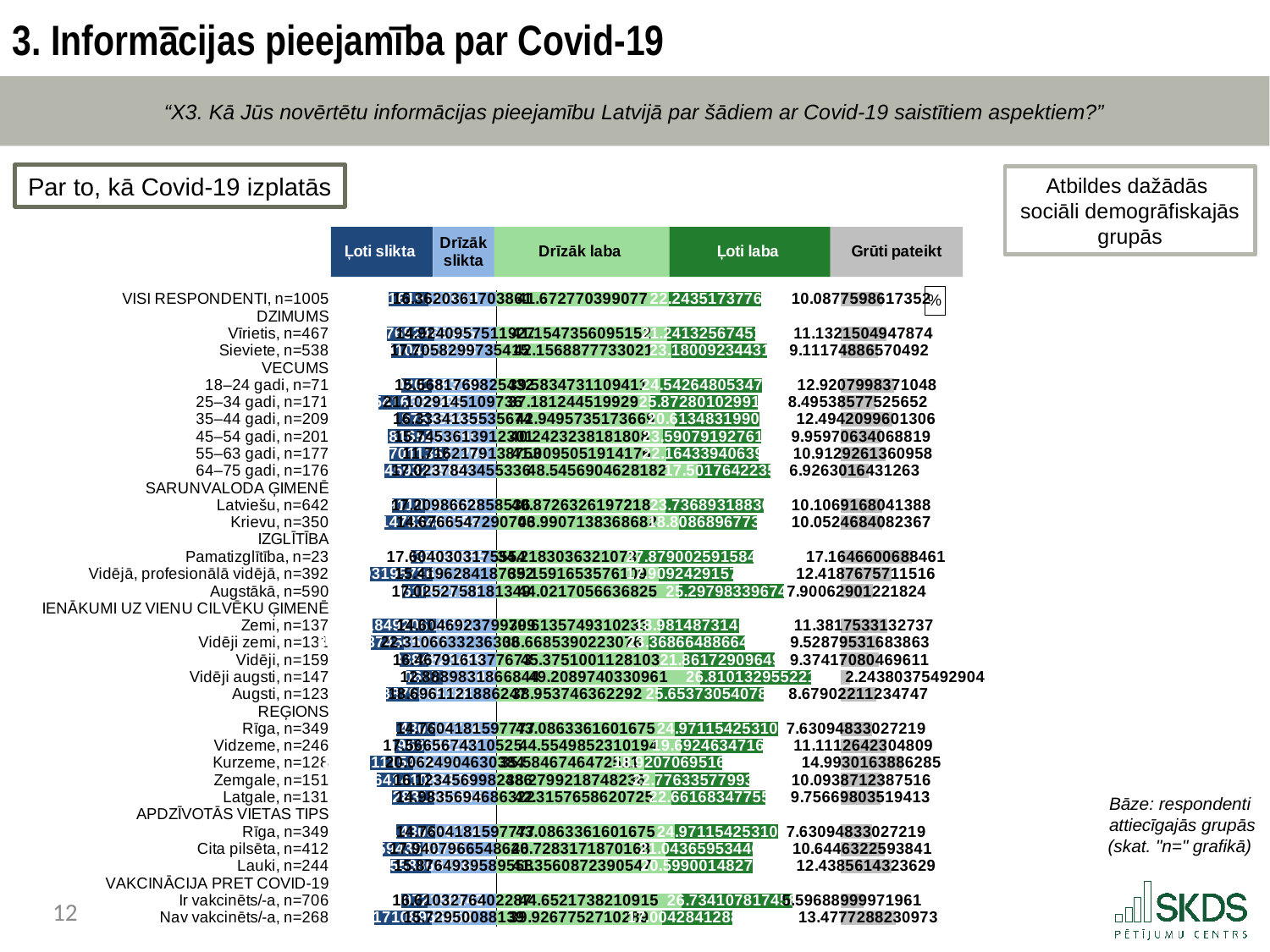
How many respondents are in the 'VISI RESPONDENTI' group according to the category label? n=1005 How many series does the chart legend list? 5 How many respondents are in the 'Vīrietis' group according to the category label? n=467 What is the last entry in the chart legend? Grūti pateikt What is the first entry in the chart legend? Ļoti slikta How many respondents are in the 'Nav vakcinēts/-a' group according to the category label? n=268 What kind of chart is shown on the slide? bar chart